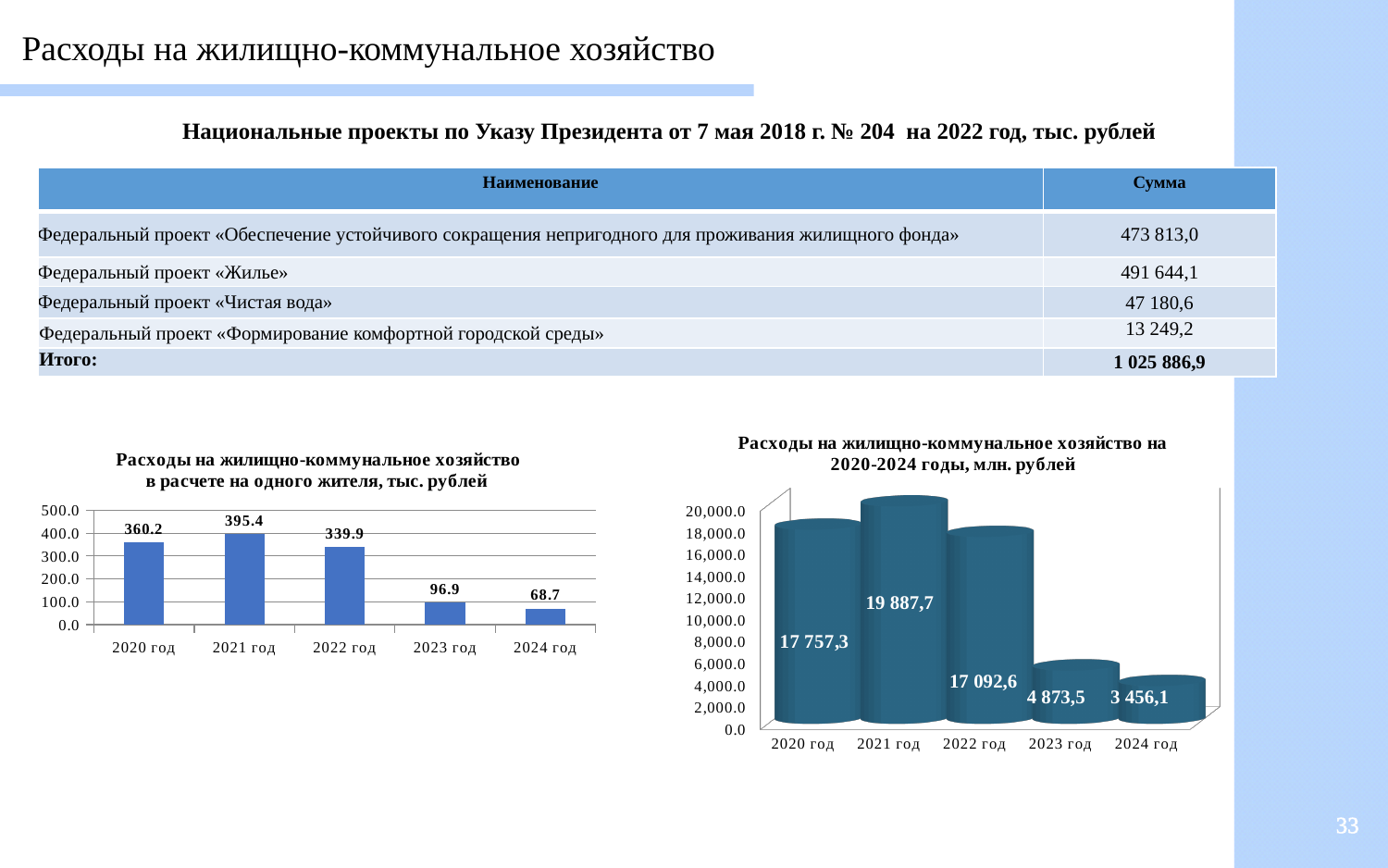
In the left chart (per-resident expenses, тыс. рублей), which year has the lowest value? 2024 год What kind of chart is the left chart (per-resident expenses, тыс. рублей)? bar chart In the left chart (per-resident expenses, тыс. рублей), how many years are shown on the x axis? 5 In the right chart (expenses for 2020-2024, млн. рублей), which is larger: the value for 2020 год or 2022 год? 2020 год In the left chart (per-resident expenses, тыс. рублей), what is the value for 2024 год? 68.7 In the left chart (per-resident expenses, тыс. рублей), what is the difference between the values for 2020 год and 2022 год? 20.3 In the right chart (expenses for 2020-2024, млн. рублей), what is the value for 2023 год? 4 873,5 In the left chart (per-resident expenses, тыс. рублей), which year has the highest value? 2021 год In the right chart (expenses for 2020-2024, млн. рублей), is the value for 2021 год greater or less than 18,000.0? greater In the right chart (expenses for 2020-2024, млн. рублей), what is the value for 2021 год? 19 887,7 In the right chart (expenses for 2020-2024, млн. рублей), which year has the lowest value? 2024 год In the left chart (per-resident expenses, тыс. рублей), what is the value for 2021 год? 395.4